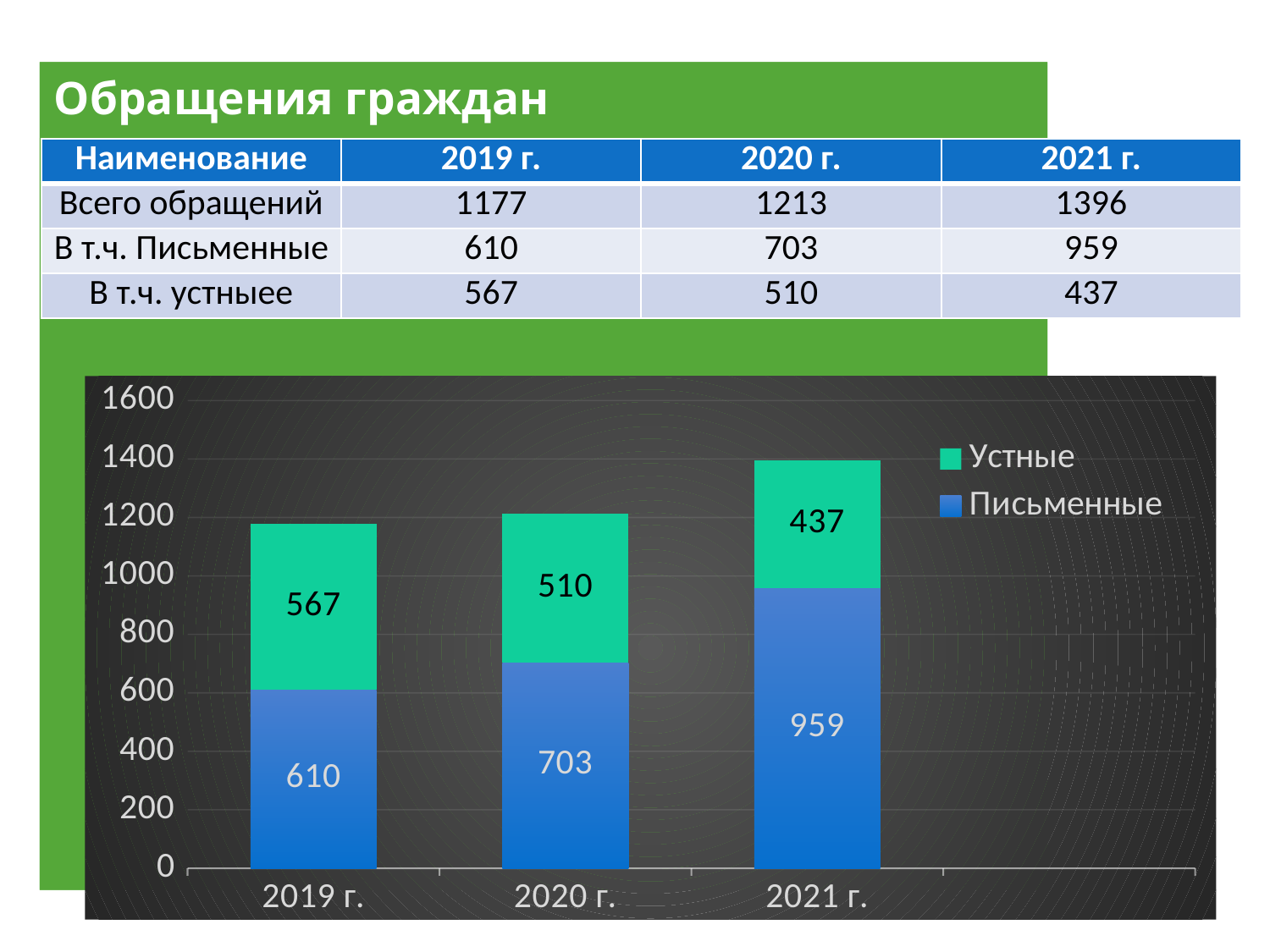
Which year has the highest value for Письменные? 2021 г. How many series does the legend list? 2 What is the difference between Письменные in 2021 г. and Письменные in 2019 г.? 349 What is the total of the stacked bar for 2019 г.? 1177 What is the value for Письменные in 2019 г.? 610 What is the value for Письменные in 2020 г.? 703 Which year has the lowest value for Устные? 2021 г. Which is larger: Устные in 2019 г. or Устные in 2020 г.? Устные in 2019 г. What is the total of the stacked bar for 2021 г.? 1396 What is the value for Устные in 2021 г.? 437 How many years are shown on the x axis? 3 What kind of chart is shown? Stacked bar chart